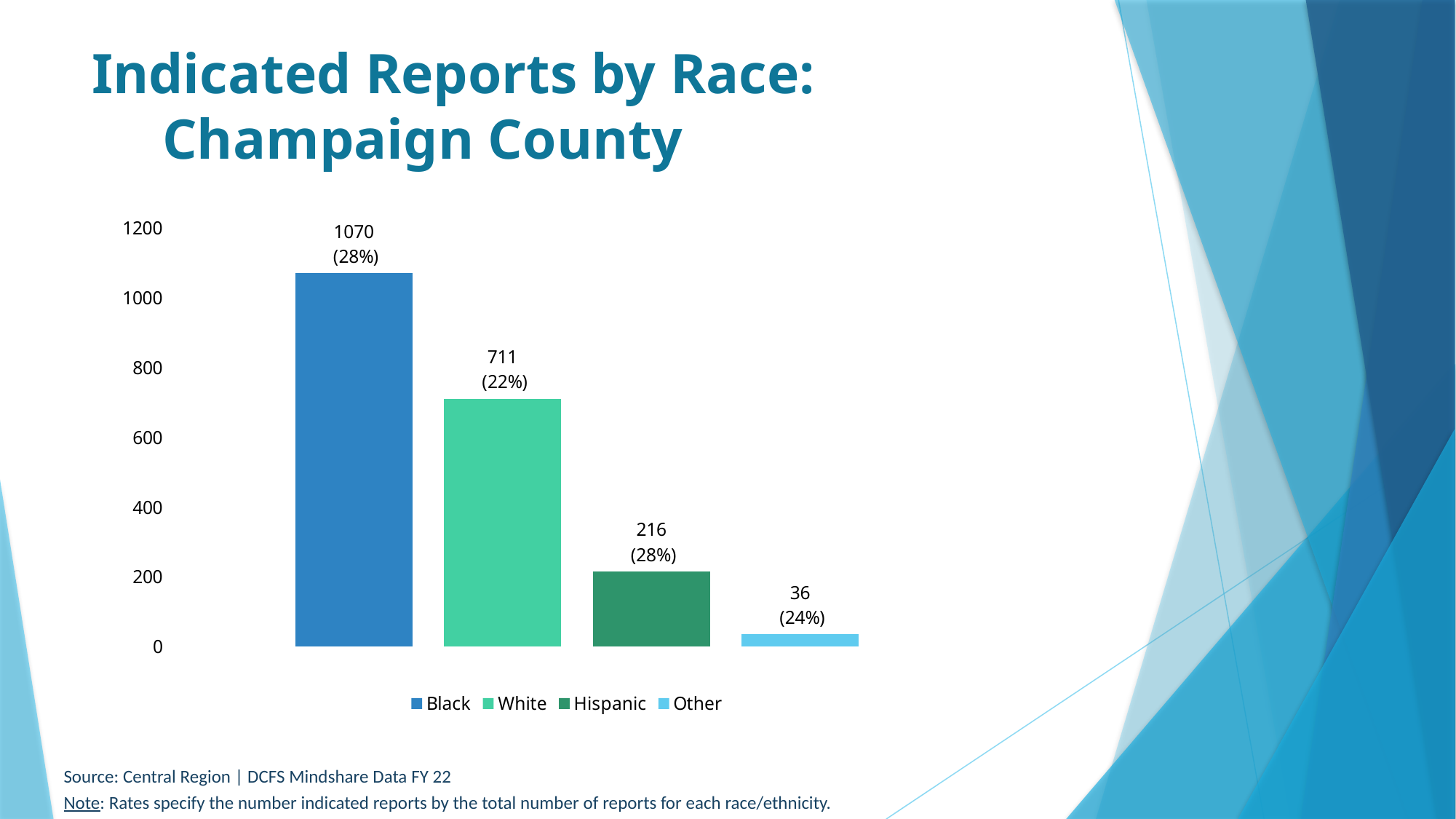
What is the difference between the number of indicated reports for Black and White? 359 How many indicated reports are shown for White? 711 Which has more indicated reports, Hispanic or Other? Hispanic What kind of chart is shown on the slide? bar chart Which category has the lowest number of indicated reports? Other How many categories are shown in the chart? 4 What is the title of the slide? Indicated Reports by Race: Champaign County How many indicated reports are shown for Black? 1070 What rate is shown in parentheses for Other? 24% How many indicated reports are shown for Hispanic? 216 Is the value for White greater or less than 800? less Which category has the highest number of indicated reports? Black